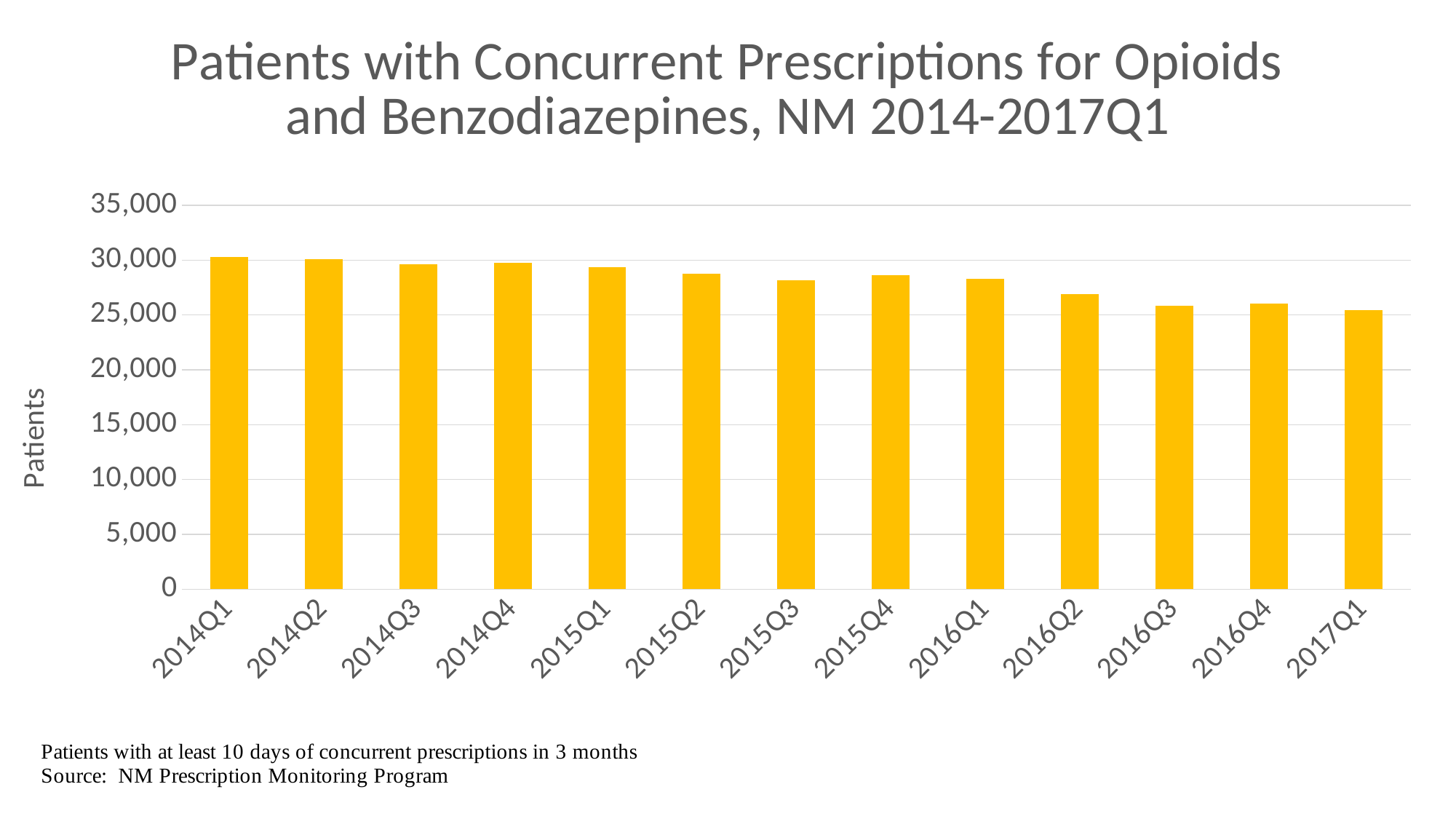
Do the values generally rise or fall from 2014Q1 to 2017Q1? Fall What kind of chart is shown on the slide? Bar chart Which is larger, the value for 2014Q1 or the value for 2017Q1? 2014Q1 Which is larger, the value for 2015Q1 or the value for 2016Q3? 2015Q1 Is the value for 2017Q1 greater or less than 20,000? greater Is the value for 2016Q3 greater or less than 30,000? less Is the value for 2015Q3 greater or less than 25,000? greater What source is cited for the chart data? NM Prescription Monitoring Program What is the label on the vertical axis? Patients How many quarters are plotted on the chart? 13